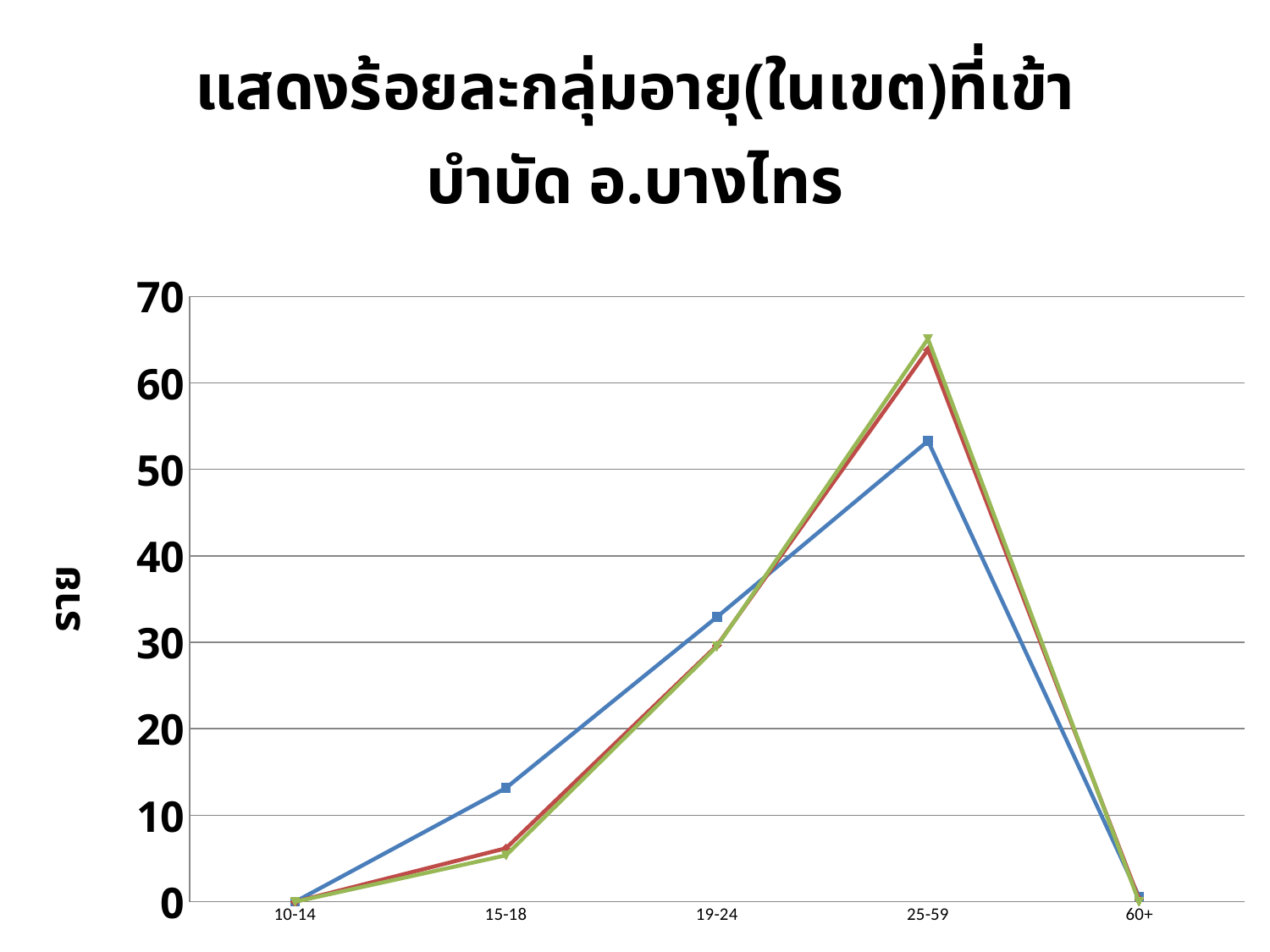
How many lines are plotted on the chart? 3 Is the value of the blue line for 15-18 greater or less than 10? greater Do the values of the blue line rise or fall from 25-59 to 60+? fall Is the value of the blue line for 25-59 greater or less than 50? greater Is the value of the red line for 25-59 greater or less than 60? greater What kind of chart is shown on the slide? line chart How many age-group categories are shown on the x axis? 5 For the red line, which age group has the highest value? 25-59 At 15-18, which line has the larger value, the blue line or the green line? blue line For the blue line, which age group has the highest value? 25-59 At 25-59, which line has the larger value, the blue line or the red line? red line